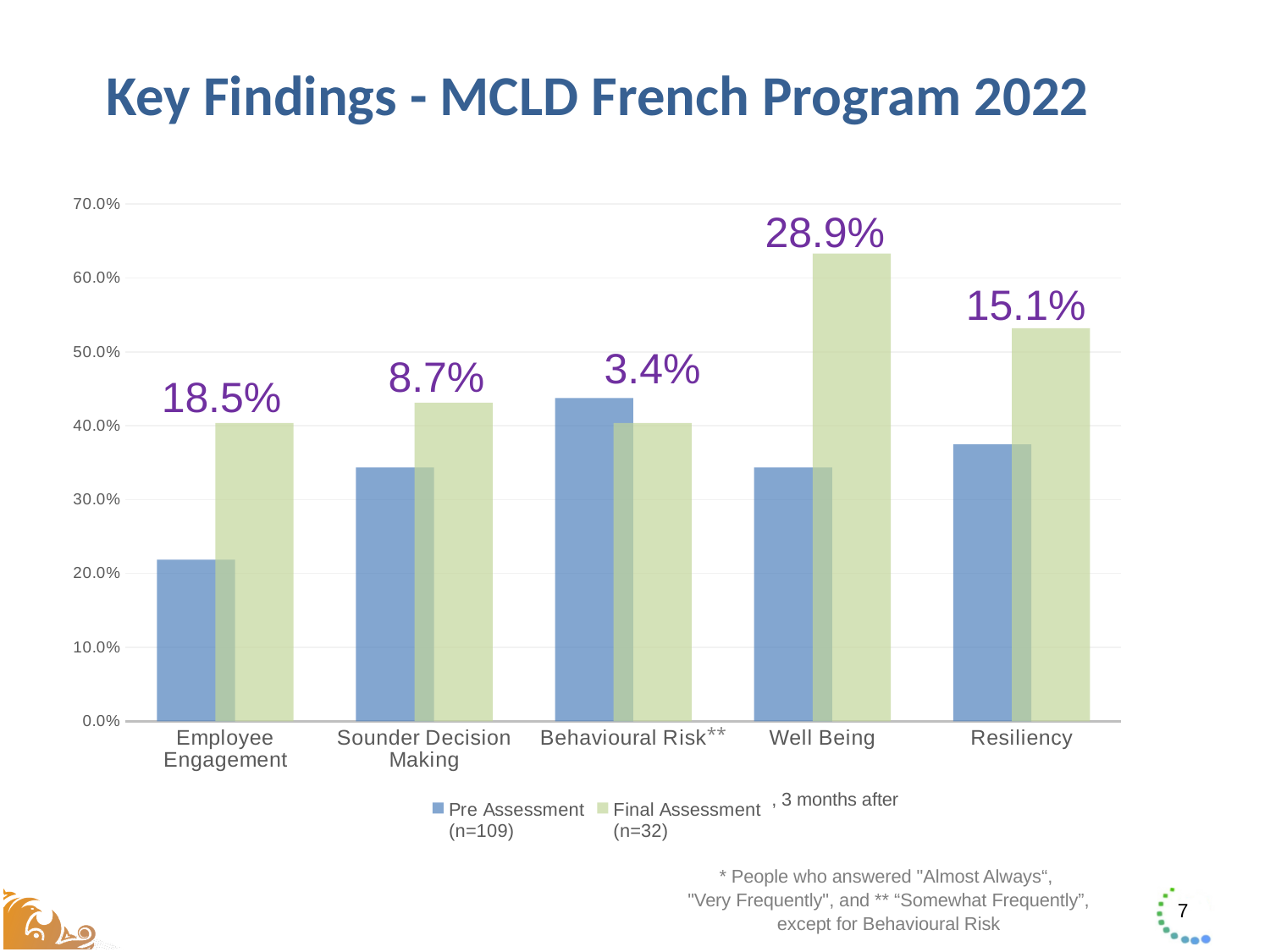
For Well Being, which is larger: the Pre Assessment bar or the Final Assessment bar? Final Assessment What percentage is printed in large purple text above the Well Being bars? 28.9% How many series does the chart's legend list? 2 For Behavioural Risk**, which is larger: the Pre Assessment bar or the Final Assessment bar? Pre Assessment Is the Pre Assessment value for Employee Engagement greater or less than 30.0%? less How many categories are shown on the x axis of the chart? 5 Is the Final Assessment value for Well Being greater or less than 60.0%? greater Which category has the highest Pre Assessment bar? Behavioural Risk** What kind of chart is shown on the slide? bar chart Which category has the highest Final Assessment bar? Well Being Which category has the lowest Pre Assessment bar? Employee Engagement What sample size is given in the legend for the Pre Assessment series? n=109